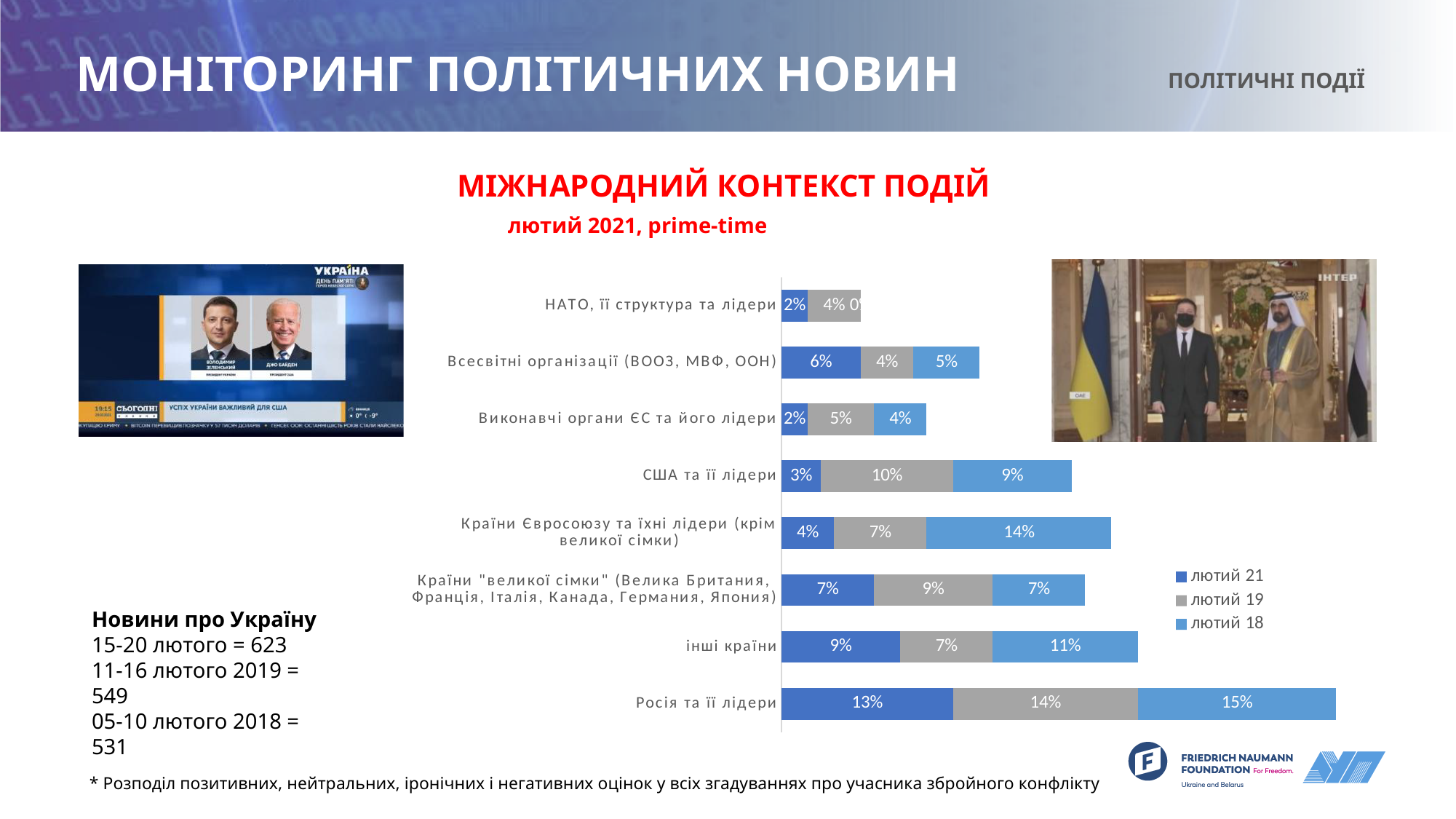
What is the total of the stacked bar for "Росія та її лідери"? 42% What is the value for "Росія та її лідери" in the "лютий 21" series? 13% How many series does the legend list? 3 What is the value for "Країни Євросоюзу та їхні лідери (крім великої сімки)" in the "лютий 18" series? 14% What is the value for "США та її лідери" in the "лютий 19" series? 10% Which category has the highest value in the "лютий 21" series? Росія та її лідери What is the difference between the "лютий 18" and "лютий 21" values for "інші країни"? 2% Which legend entry is shown in grey? лютий 19 Which category has the lowest value in the "лютий 18" series? НАТО, її структура та лідери What kind of chart is shown on the slide? stacked bar chart How many categories are plotted on the chart? 8 Which is larger for "Всесвітні організації (ВООЗ, МВФ, ООН)": the "лютий 21" value or the "лютий 19" value? лютий 21